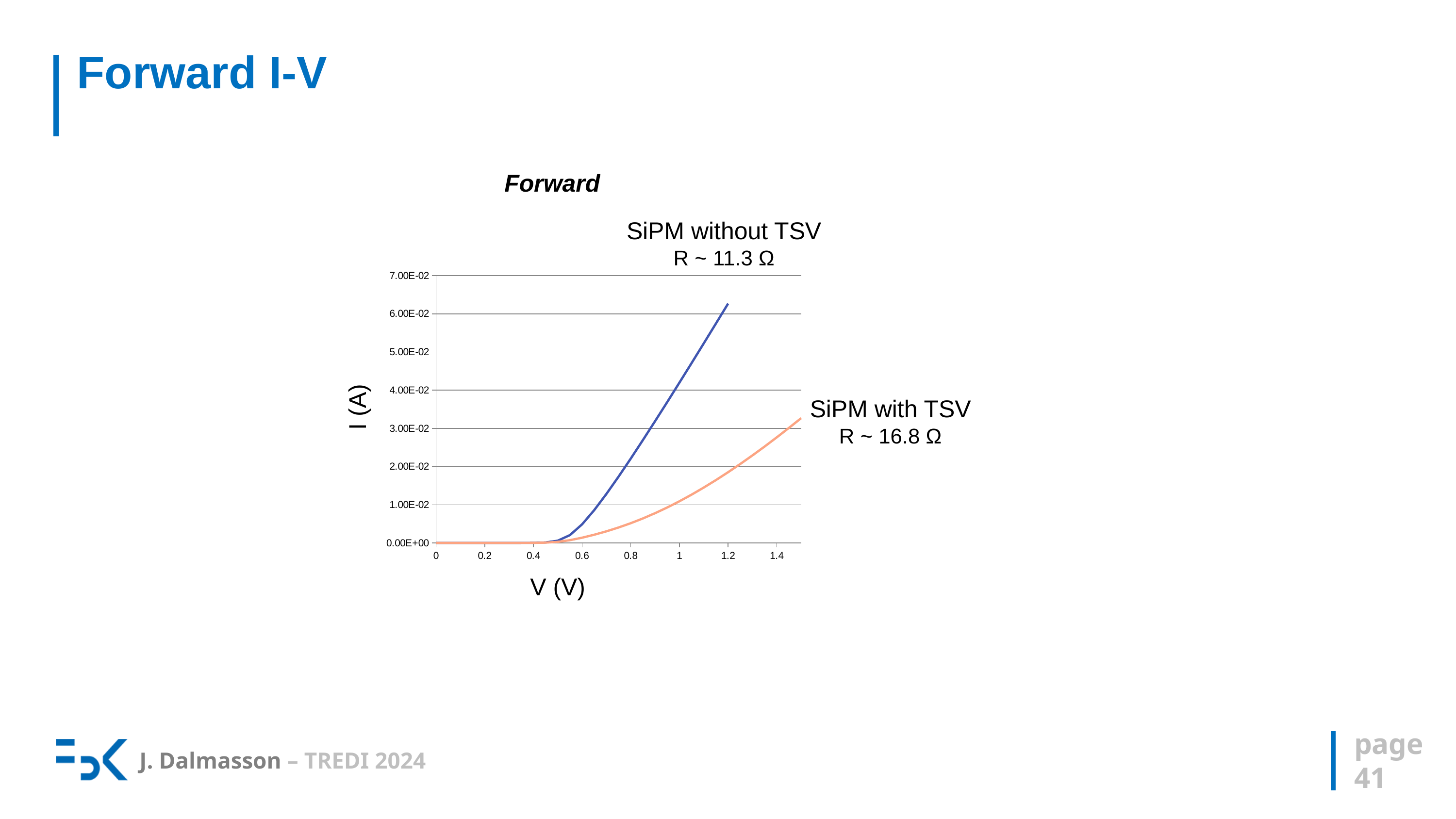
At V = 1 V, which series shows the higher current, SiPM with TSV or SiPM without TSV? SiPM without TSV What kind of chart is shown on the slide? line chart What is the difference between the resistance of the SiPM with TSV and the SiPM without TSV? 5.5 Ω Which series has the larger resistance value, SiPM with TSV or SiPM without TSV? SiPM with TSV Is the current for the SiPM with TSV at V = 0.8 V greater or less than 1.00E-02 A? less What is the title of the chart? Forward What resistance is given for the SiPM without TSV? R ~ 11.3 Ω What is the label of the x axis of the chart? V (V) What resistance is given for the SiPM with TSV? R ~ 16.8 Ω Does the current for the SiPM without TSV rise or fall as the voltage increases above 0.5 V? rise How many series are plotted in the Forward chart? 2